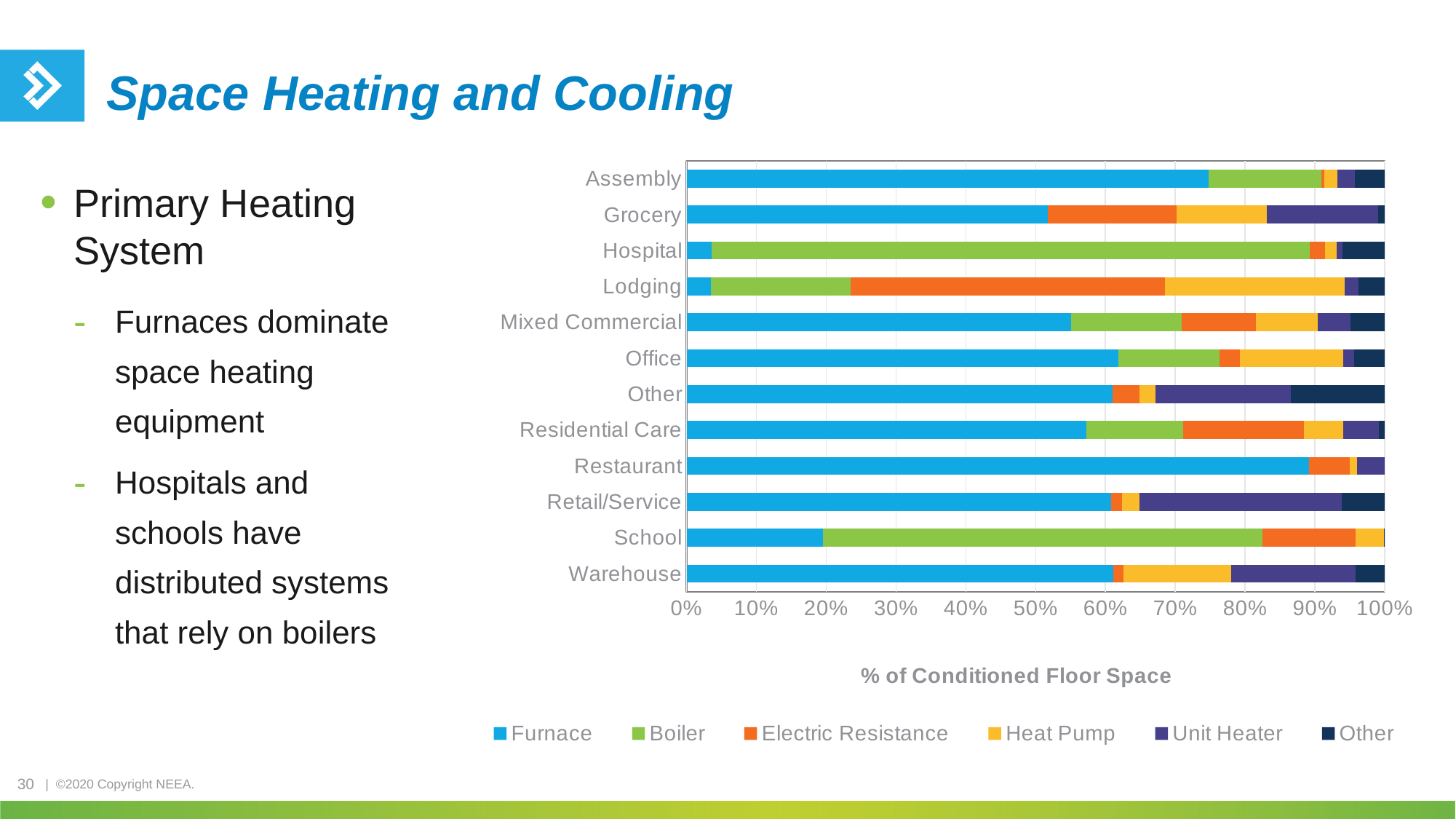
Which building type has the largest Boiler share? Hospital What is the title of the x axis? % of Conditioned Floor Space How many heating system types does the legend list? 6 How many building types (categories) are plotted on the chart? 12 Is the Furnace share for Restaurant greater or less than 80%? greater Is the Furnace share for School greater or less than 30%? less What kind of chart is shown on the slide? Stacked bar chart Which building type has the largest Unit Heater share? Retail/Service Which building type has the largest Furnace share? Restaurant Is the Boiler share for School greater or less than 50%? greater Which has the larger Furnace share, Assembly or Grocery? Assembly